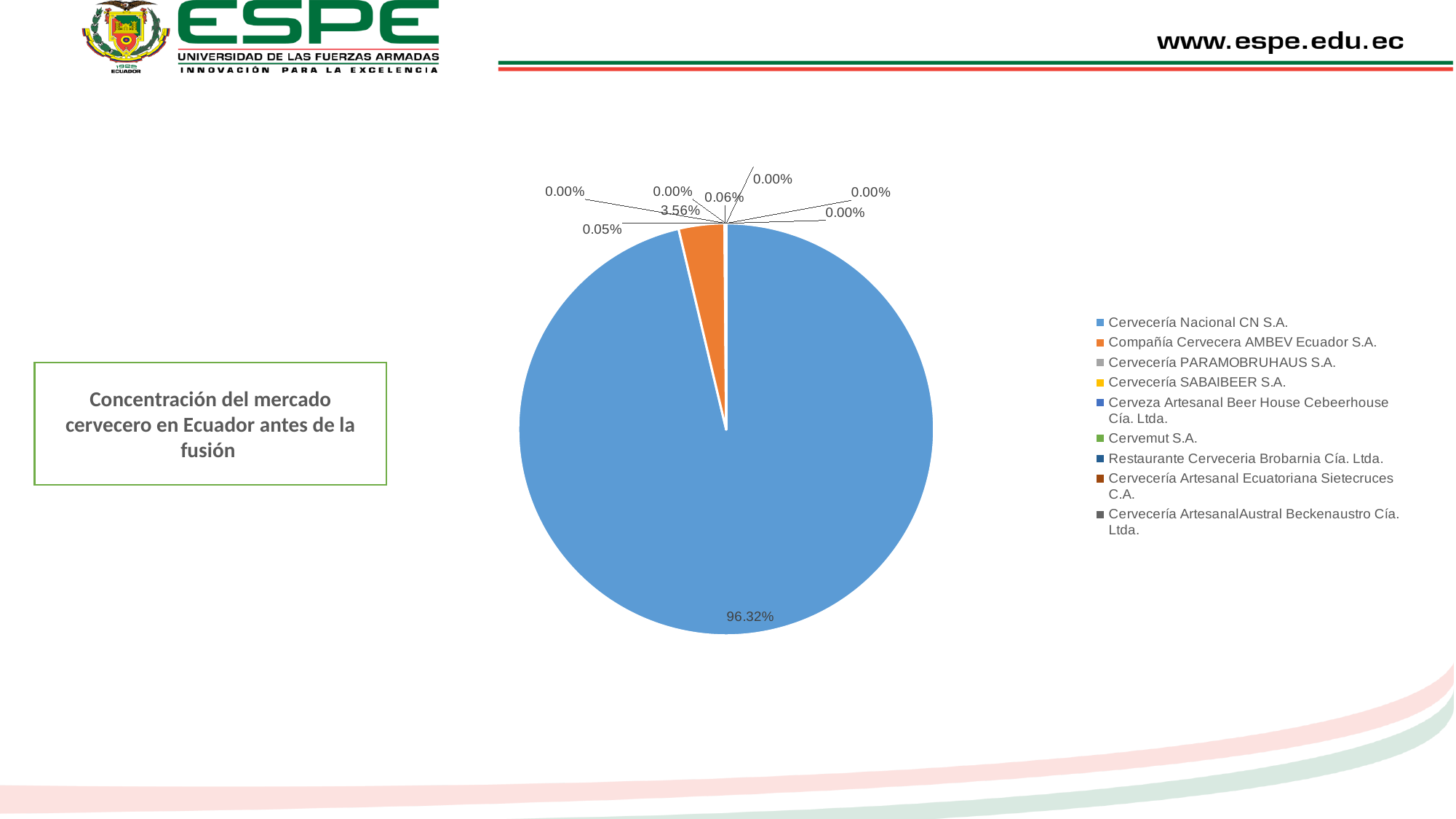
What colour is the slice for Cervecería Nacional CN S.A.? blue What is the value shown for Compañía Cervecera AMBEV Ecuador S.A.? 3.56% What is the difference in percentage points between the Cervecería Nacional CN S.A. slice and the Compañía Cervecera AMBEV Ecuador S.A. slice? 92.76 percentage points Which is larger, the slice for Cervecería Nacional CN S.A. or the slice for Compañía Cervecera AMBEV Ecuador S.A.? Cervecería Nacional CN S.A. What share of the pie does Cervecería Nacional CN S.A. hold? 96.32% What is the title given for the chart in the text box on the slide? Concentración del mercado cervecero en Ecuador antes de la fusión Which company has the largest slice of the pie? Cervecería Nacional CN S.A. What is the second-largest slice value shown on the pie chart? 3.56% How many companies are listed in the legend of the pie chart? 9 What type of chart is shown on the slide? pie chart